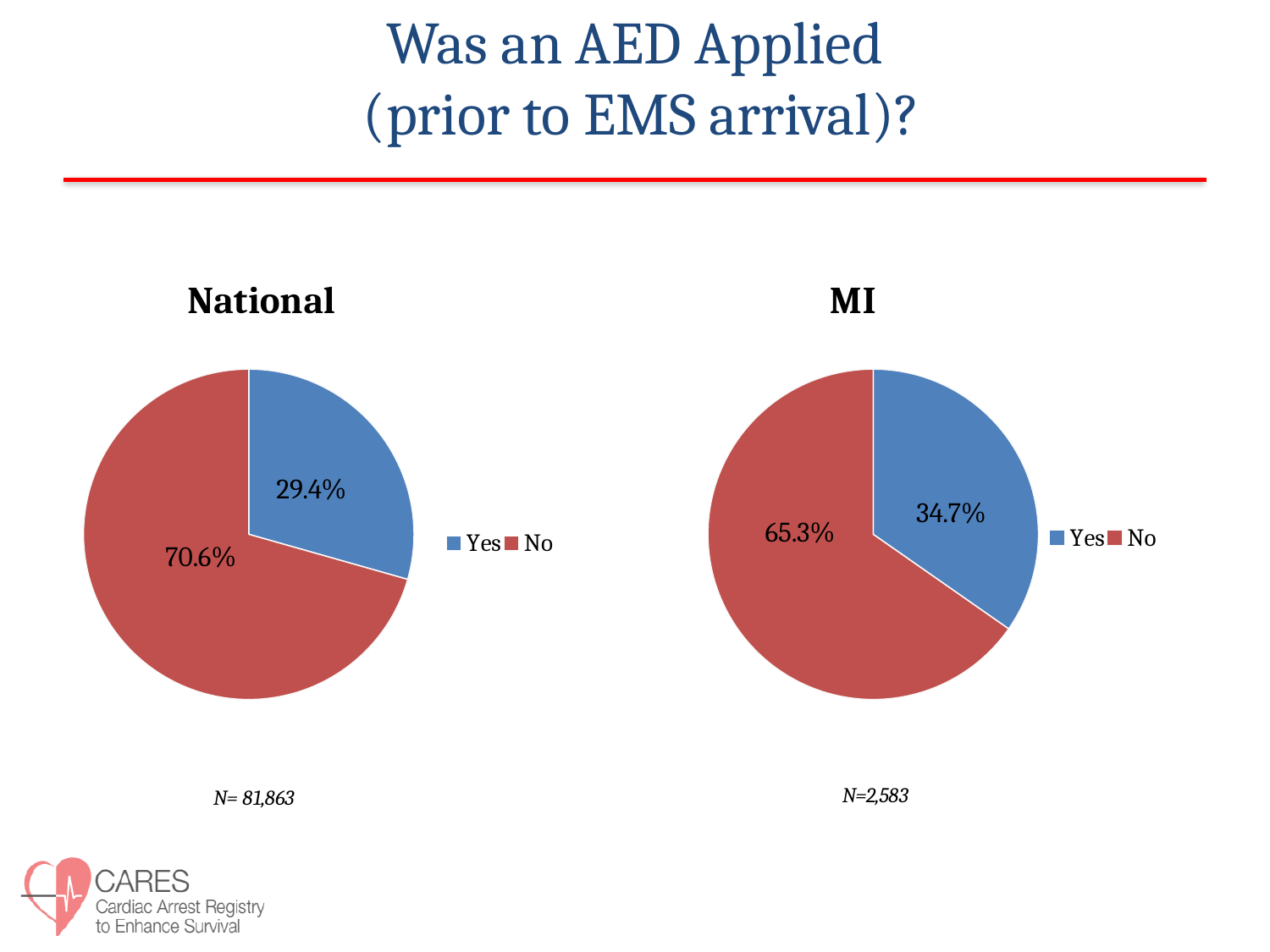
In the National chart, which slice is the smallest? Yes In the MI chart, what share of cases did not have an AED applied (No)? 65.3% In the MI chart, which slice is the largest? No In the National chart, what share of cases had an AED applied (Yes)? 29.4% How many entries does the legend of the National chart list? 2 What is the difference between the No and Yes shares in the National chart? 41.2% In the National chart, what share of cases did not have an AED applied (No)? 70.6% In the MI chart, what share of cases had an AED applied (Yes)? 34.7% Is the Yes share larger in the National chart or the MI chart? MI How many slices does the MI pie chart have? 2 What colour represents the No category in the MI chart? Red What type of chart is used for the National data? Pie chart